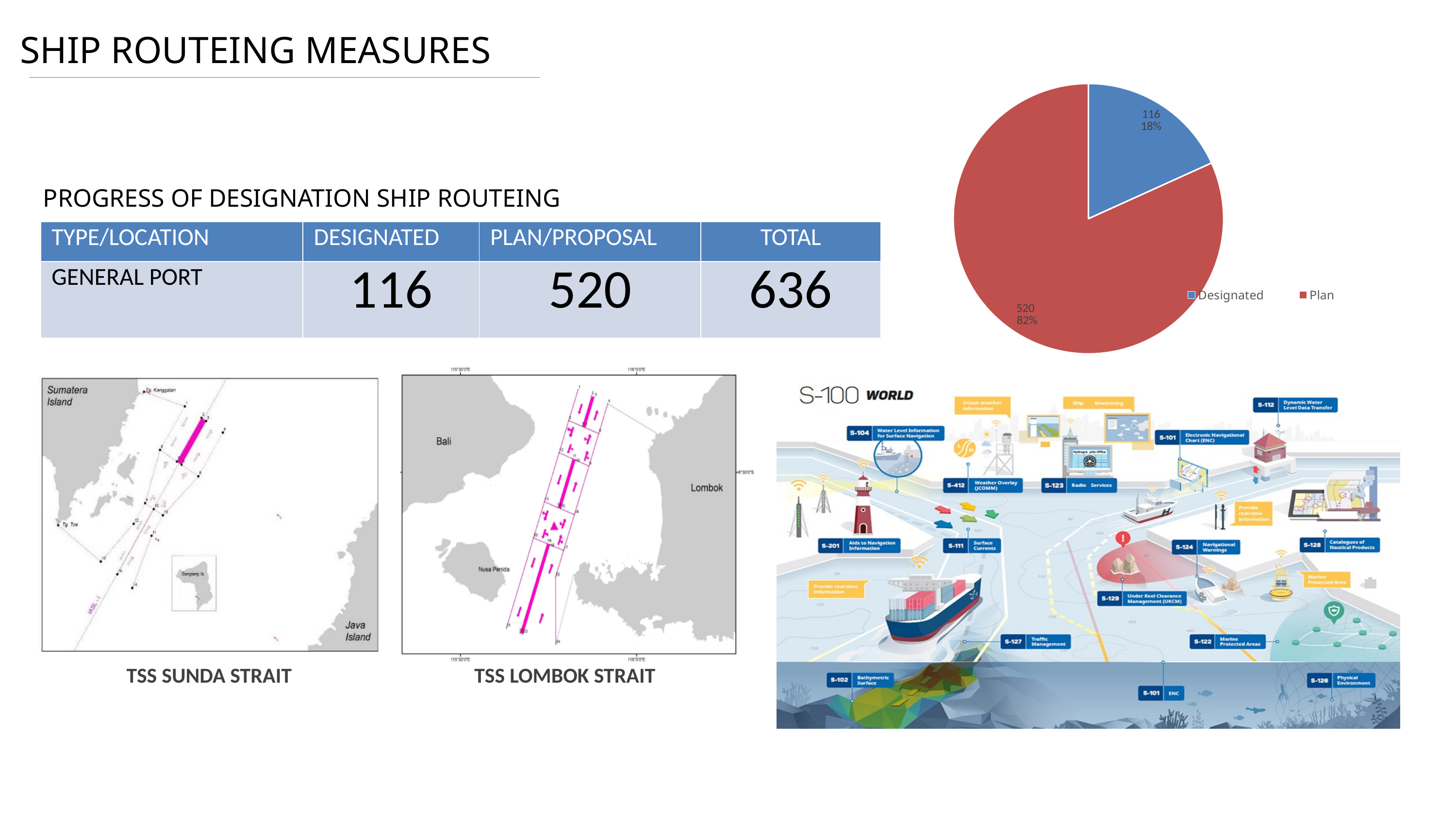
How many slices does the pie chart have? 2 In the pie chart, what colour is the Plan slice? red In the pie chart, which is larger, Designated or Plan? Plan In the pie chart, what is the difference between the Plan value and the Designated value? 404 In the pie chart, what is the value for Plan? 520 What kind of chart is shown in the top right of the slide? pie chart In the pie chart, which slice is the smallest? Designated How many entries does the pie chart's legend list? 2 In the pie chart, which slice is the largest? Plan In the pie chart, what is the value for Designated? 116 In the pie chart, what percentage share does the Designated slice have? 18% In the pie chart, what percentage share does the Plan slice have? 82%